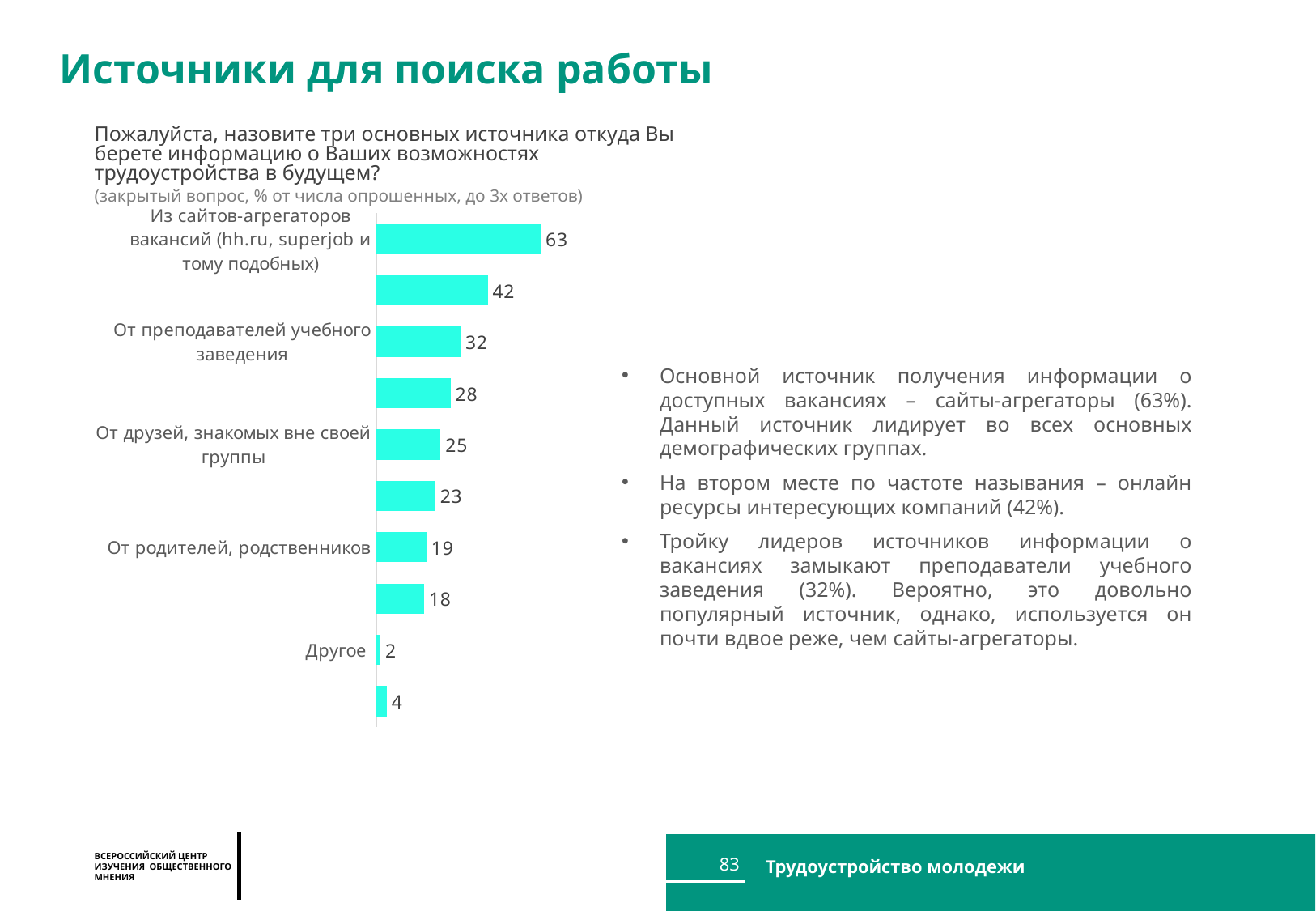
How many bars are plotted in the chart? 10 What is the value for "От друзей, знакомых вне своей группы"? 25 Which category has the highest value? Из сайтов-агрегаторов вакансий (hh.ru, superjob и тому подобных) What is the difference between the values for "Из сайтов-агрегаторов вакансий (hh.ru, superjob и тому подобных)" and "От преподавателей учебного заведения"? 31 What is the value for "Другое"? 2 Which labeled category has the lowest value? Другое What is the value for "От родителей, родственников"? 19 What is the value for "Из сайтов-агрегаторов вакансий (hh.ru, superjob и тому подобных)"? 63 What type of chart is shown on the slide? bar chart What is the title of the slide containing the chart? Источники для поиска работы What is the value for "От преподавателей учебного заведения"? 32 Which is larger: the value for "От друзей, знакомых вне своей группы" or for "От родителей, родственников"? От друзей, знакомых вне своей группы